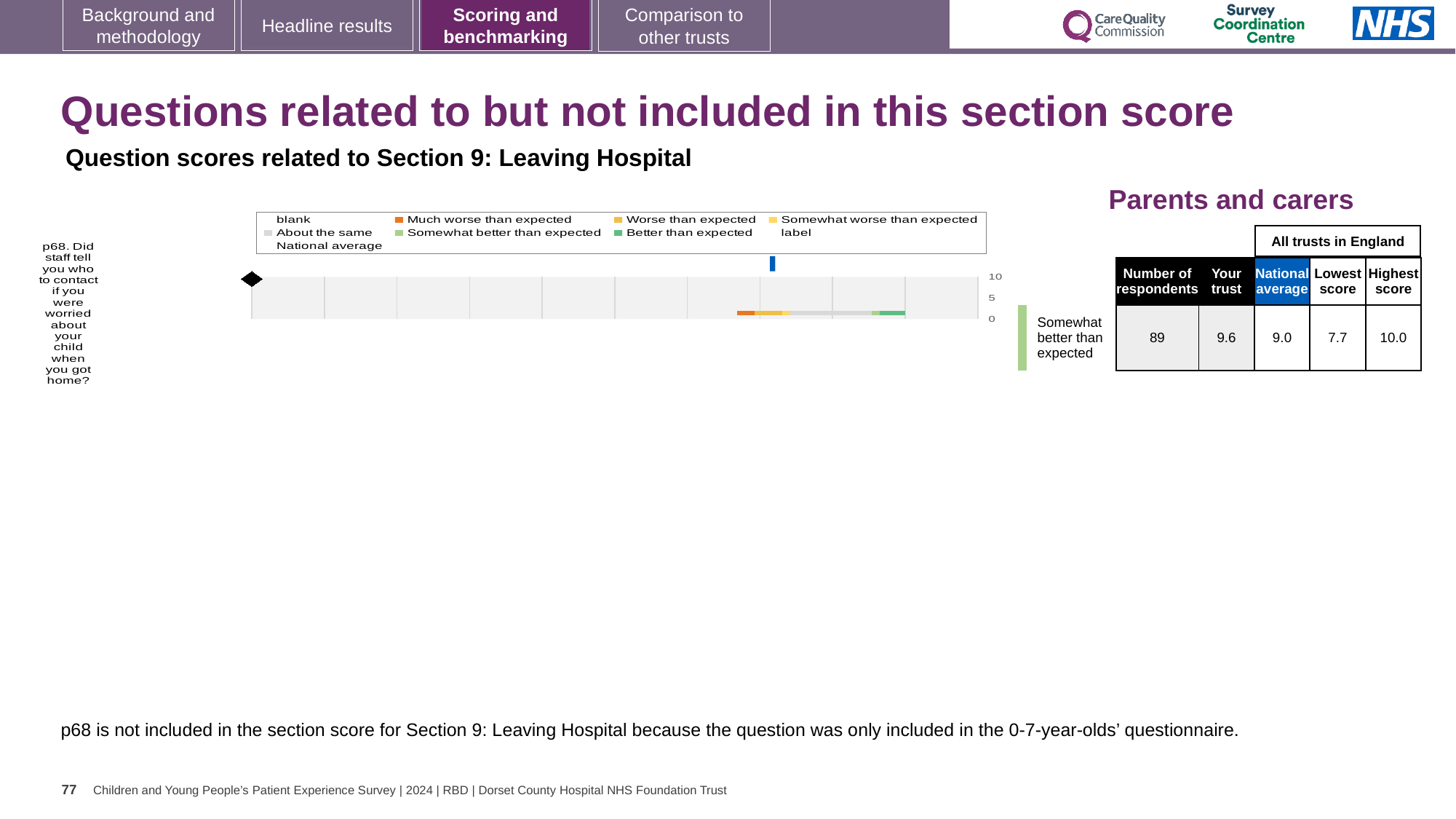
What kind of chart is used to show the p68 question score? bar chart Which is larger for question p68, the trust's score or the national average? the trust's score How many respondents answered question p68? 89 What is the lowest score among all trusts in England for question p68? 7.7 Which benchmarking category does the trust's p68 score fall into? Somewhat better than expected How many questions are plotted on the chart? 1 What is the difference between the highest and lowest scores among all trusts in England for question p68? 2.3 What is the national average score for question p68? 9.0 What is the difference between the trust's score and the national average for question p68? 0.6 What is the trust's score for question p68? 9.6 What is the highest score among all trusts in England for question p68? 10.0 What colour does the legend use for 'Much worse than expected'? orange